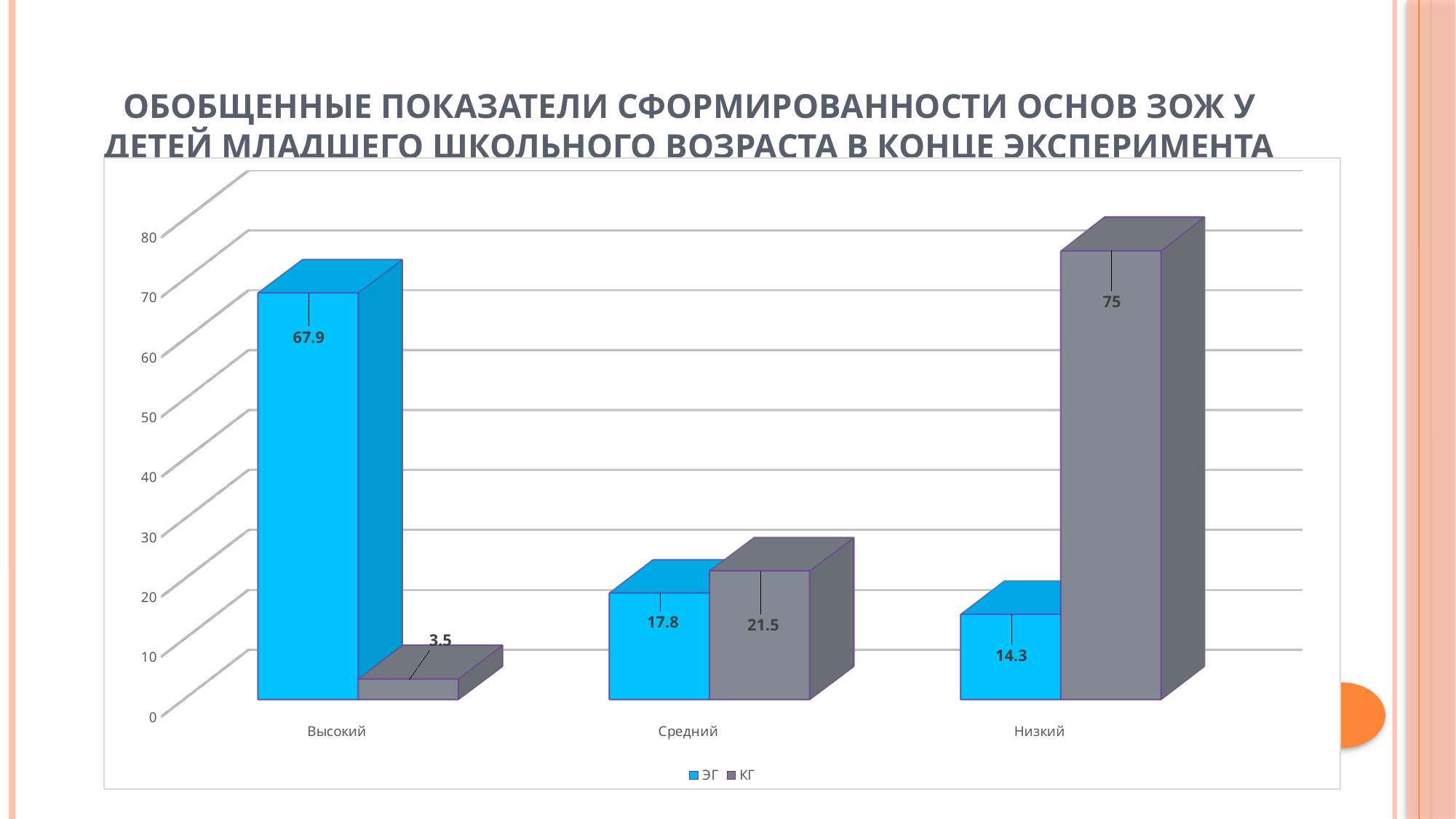
What is the value for КГ in the Средний category? 21.5 How many categories are shown on the x axis? 3 Which category has the highest value for the КГ series? Низкий How many series does the legend list? 2 Which category has the lowest value for the ЭГ series? Низкий What is the difference between the ЭГ and КГ values in the Высокий category? 64.4 What is the value for ЭГ in the Высокий category? 67.9 Which series is shown in blue? ЭГ What kind of chart is shown on the slide? Bar chart What is the value for КГ in the Низкий category? 75 In the Средний category, which series has the larger value, ЭГ or КГ? КГ What is the value for ЭГ in the Низкий category? 14.3